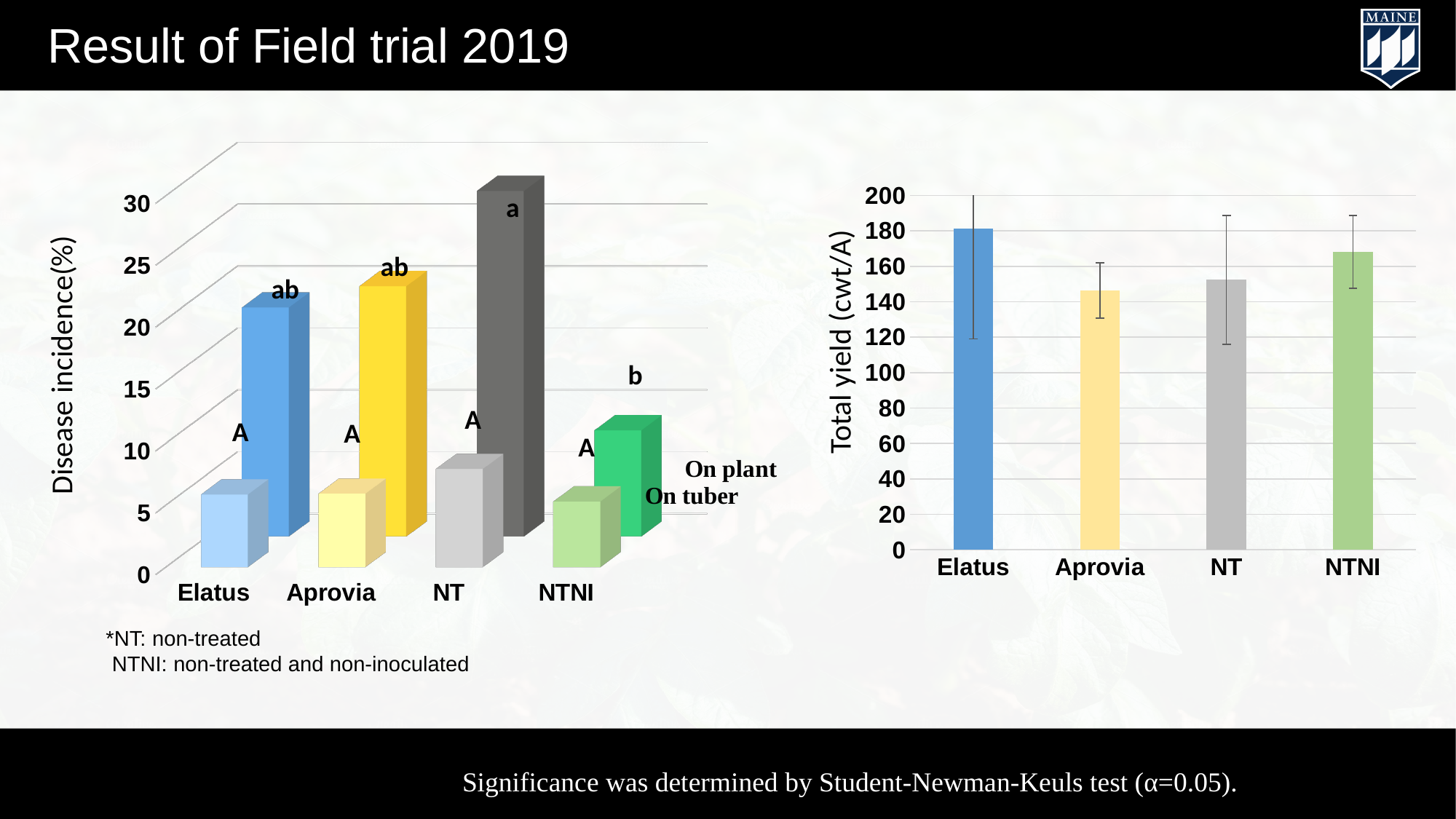
In the left chart (Disease incidence), how many categories are shown on the x axis? 4 In the left chart (Disease incidence), is the 'On plant' value for NTNI greater or less than 15? less In the left chart (Disease incidence), which category has the highest 'On plant' value? NT In the right chart (Total yield), which category has the highest total yield? Elatus In the right chart (Total yield), which is larger, the value for NTNI or the value for NT? NTNI In the right chart (Total yield), is the value for Elatus greater or less than 160? greater In the right chart (Total yield), is the value for Aprovia greater or less than 160? less What is the y-axis title of the right chart? Total yield (cwt/A) In the right chart (Total yield), which category has the lowest total yield? Aprovia In the left chart (Disease incidence), which category has the lowest 'On plant' value? NTNI